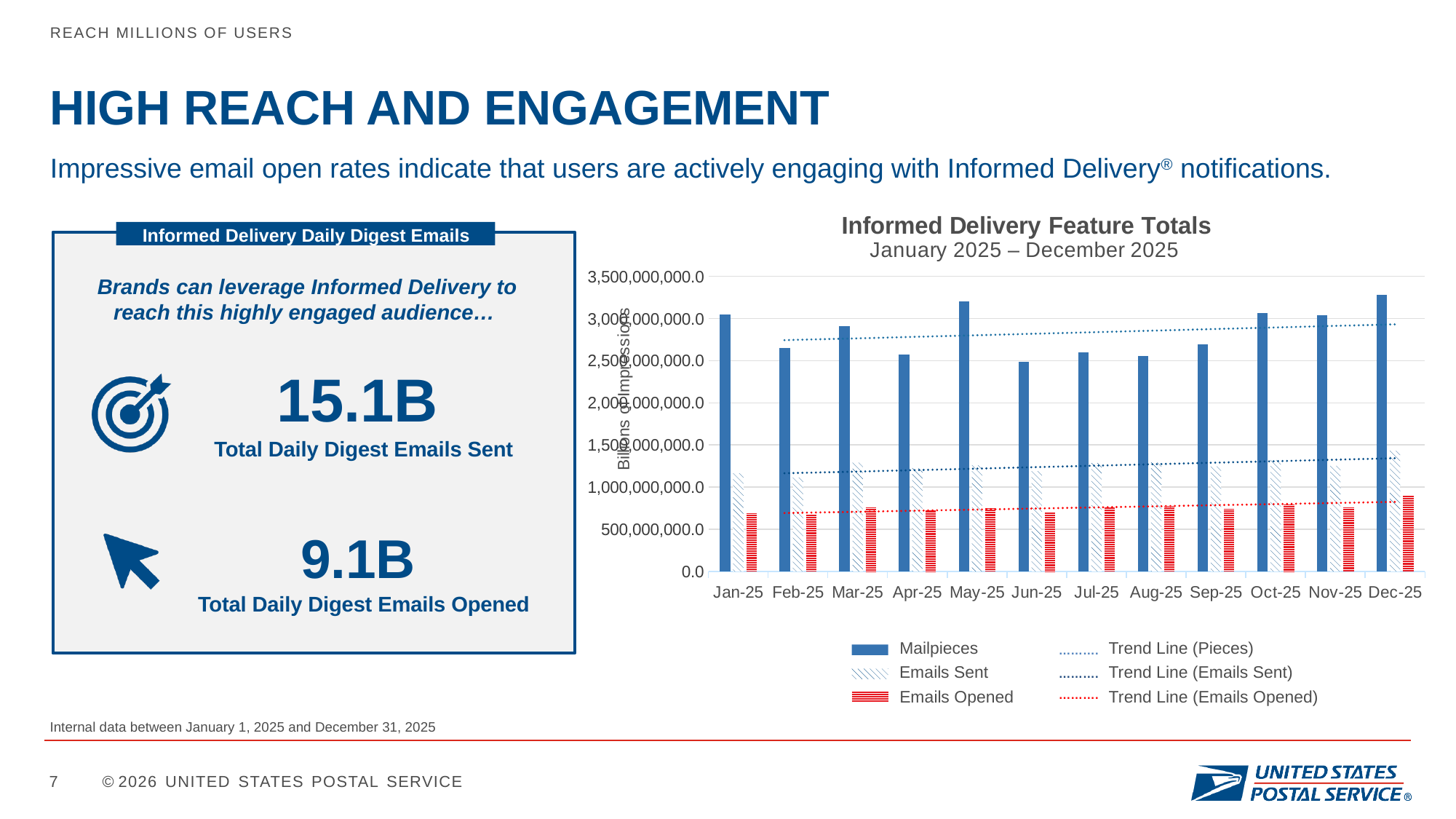
In the 'Informed Delivery Feature Totals' chart, is the Mailpieces value for Feb-25 greater or less than 3,000,000,000.0? less In the 'Informed Delivery Feature Totals' chart, does the Trend Line (Emails Opened) rise or fall from Jan-25 to Dec-25? rise In the 'Informed Delivery Feature Totals' chart, is the Mailpieces value larger for Jan-25 or Feb-25? Jan-25 How many entries does the legend of the 'Informed Delivery Feature Totals' chart list? 6 What kind of chart is 'Informed Delivery Feature Totals'? bar chart In the 'Informed Delivery Feature Totals' chart, is the Emails Opened value for Dec-25 greater or less than 1,000,000,000.0? less How many months are shown on the x axis of the 'Informed Delivery Feature Totals' chart? 12 What is the y-axis label of the 'Informed Delivery Feature Totals' chart? Billions of Impressions In the 'Informed Delivery Feature Totals' chart, is the Emails Sent value for Jan-25 greater or less than 1,000,000,000.0? greater In the 'Informed Delivery Feature Totals' chart, which month has the highest Emails Sent value? Dec-25 In the 'Informed Delivery Feature Totals' chart, which month has the highest Emails Opened value? Dec-25